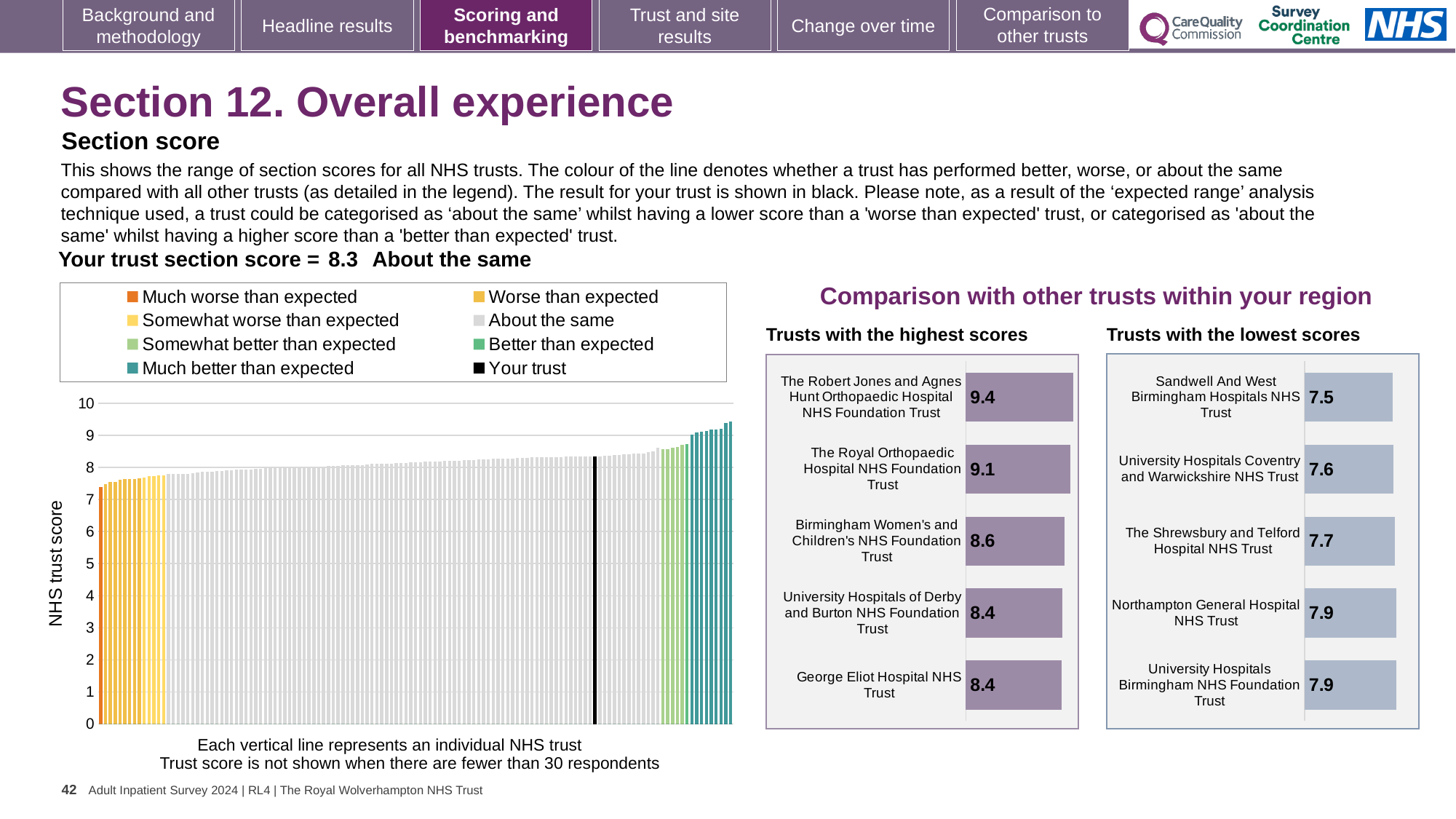
What kind of chart is the large chart on the left with the y-axis labelled 'NHS trust score'? bar chart In the 'Trusts with the highest scores' chart, what is the score for The Robert Jones and Agnes Hunt Orthopaedic Hospital NHS Foundation Trust? 9.4 In the 'Trusts with the highest scores' chart, which trust has the highest score? The Robert Jones and Agnes Hunt Orthopaedic Hospital NHS Foundation Trust In the large chart on the left, how many entries does the legend list? 8 In the 'Trusts with the lowest scores' chart, which has the larger score: The Shrewsbury and Telford Hospital NHS Trust or Northampton General Hospital NHS Trust? Northampton General Hospital NHS Trust In the large chart on the left, what is the label of the y axis? NHS trust score In the 'Trusts with the lowest scores' chart, which trust has the lowest score? Sandwell And West Birmingham Hospitals NHS Trust In the 'Trusts with the highest scores' chart, what is the difference between the scores of The Robert Jones and Agnes Hunt Orthopaedic Hospital NHS Foundation Trust and The Royal Orthopaedic Hospital NHS Foundation Trust? 0.3 In the large chart on the left, is the value of the shortest bar greater or less than 8? less In the large chart on the left, is the value of the tallest bar greater or less than 9? greater In the 'Trusts with the lowest scores' chart, what is the score for University Hospitals Coventry and Warwickshire NHS Trust? 7.6 In the 'Trusts with the highest scores' chart, how many trusts are shown? 5